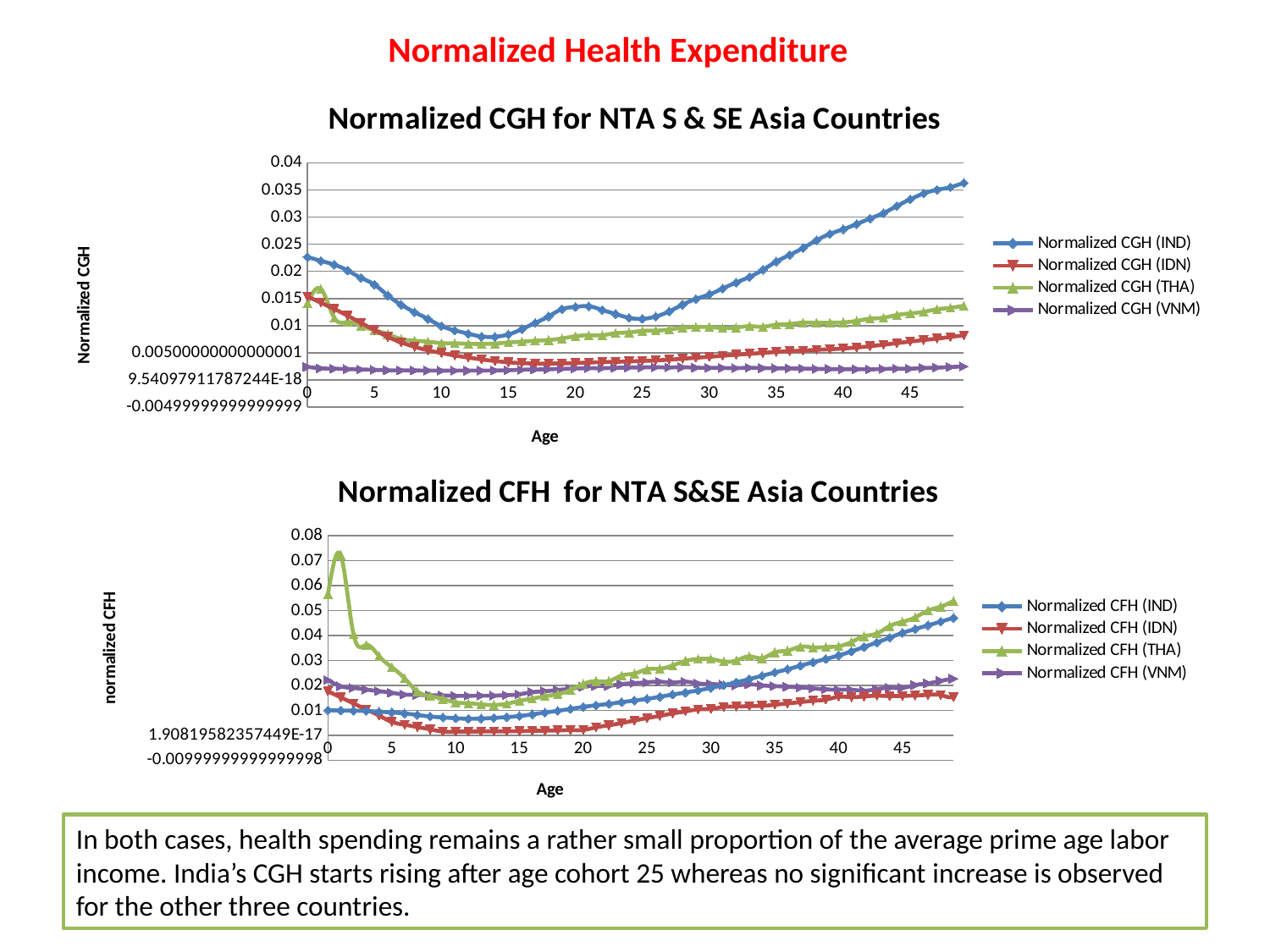
In the top chart (Normalized CGH), which series has the lowest value at age 45? Normalized CGH (VNM) In the bottom chart (Normalized CFH), which is larger at age 10: Normalized CFH (VNM) or Normalized CFH (IND)? Normalized CFH (VNM) In the bottom chart (Normalized CFH), is the value for Normalized CFH (IDN) at age 20 greater or less than 0.01? less In the bottom chart (Normalized CFH), is the peak value of Normalized CFH (THA) near age 1 greater or less than 0.06? greater In the top chart (Normalized CGH), does the Normalized CGH (IND) series rise or fall between age 25 and age 45? rise In the top chart (Normalized CGH), which is larger at age 0: Normalized CGH (IND) or Normalized CGH (VNM)? Normalized CGH (IND) In the top chart (Normalized CGH), which series has the highest value at age 45? Normalized CGH (IND) In the top chart (Normalized CGH), is the value for Normalized CGH (IND) at age 45 greater or less than 0.03? greater What kind of chart is the top chart, 'Normalized CGH for NTA S & SE Asia Countries'? line chart In the bottom chart (Normalized CFH), which series has the highest value at age 45? Normalized CFH (THA) What is the x-axis label of the bottom chart, 'Normalized CFH for NTA S&SE Asia Countries'? Age How many series does the legend of the top chart (Normalized CGH) list? 4